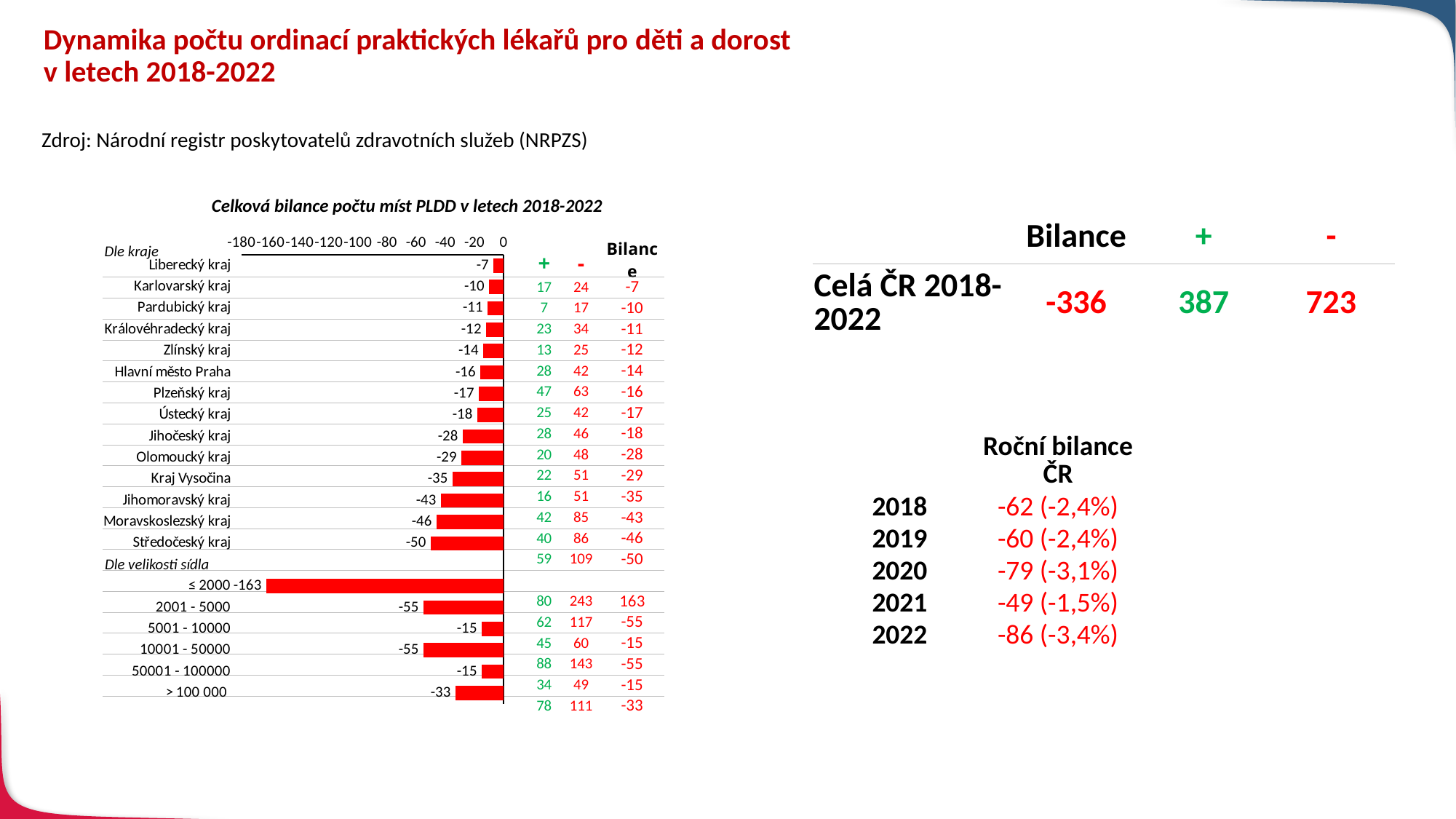
How many settlement size categories are listed under Dle velikosti sídla? 6 Which has the more negative value, Kraj Vysočina or Olomoucký kraj? Kraj Vysočina Which region (Dle kraje) has the lowest (most negative) value? Středočeský kraj What is the value for Středočeský kraj in the chart? -50 Which region (Dle kraje) has the highest (least negative) value? Liberecký kraj What is the value for the ≤ 2000 settlement size category? -163 What is the value for Hlavní město Praha? -16 What type of chart is shown on the slide? Bar chart What is the title of the chart? Celková bilance počtu míst PLDD v letech 2018-2022 What is the value for the > 100 000 settlement size category? -33 What is the difference between the values for Moravskoslezský kraj and Jihomoravský kraj? 3 How many regions are listed under Dle kraje in the chart? 14